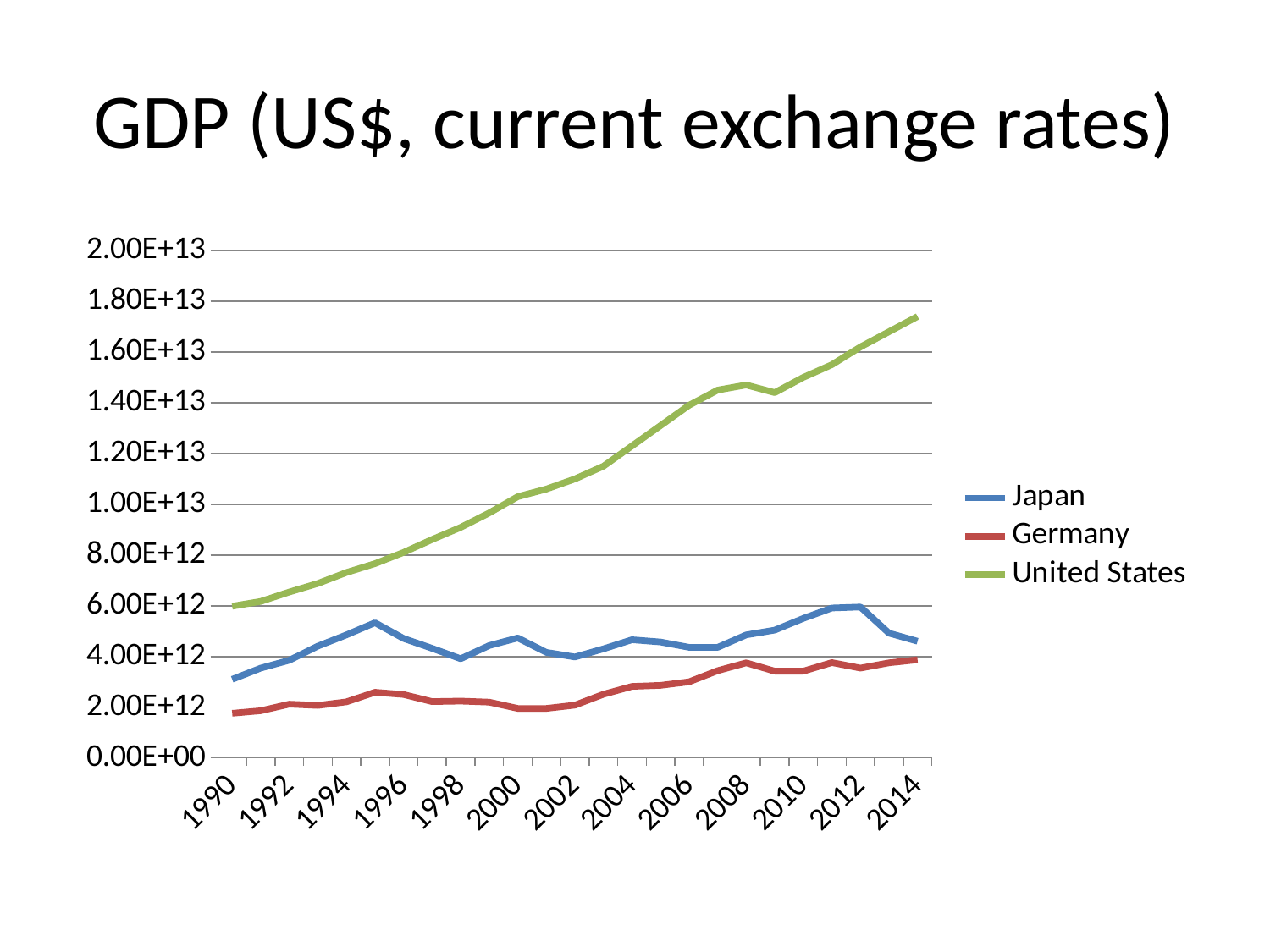
In 2010, which is larger, the value for Japan or the value for Germany? Japan Is the value for Japan in 1990 greater or less than 4.00E+12? less Which series has the lowest values across the whole period? Germany Which series has the highest values across the whole period? United States Does the United States series rise or fall overall from 1990 to 2014? rise Is the value for United States in 2000 greater or less than 8.00E+12? greater What kind of chart is shown on the slide? line chart How many series does the legend list? 3 Is the value for Germany in 2002 greater or less than 4.00E+12? less What is the title of the chart? GDP (US$, current exchange rates) Which series is drawn in green? United States